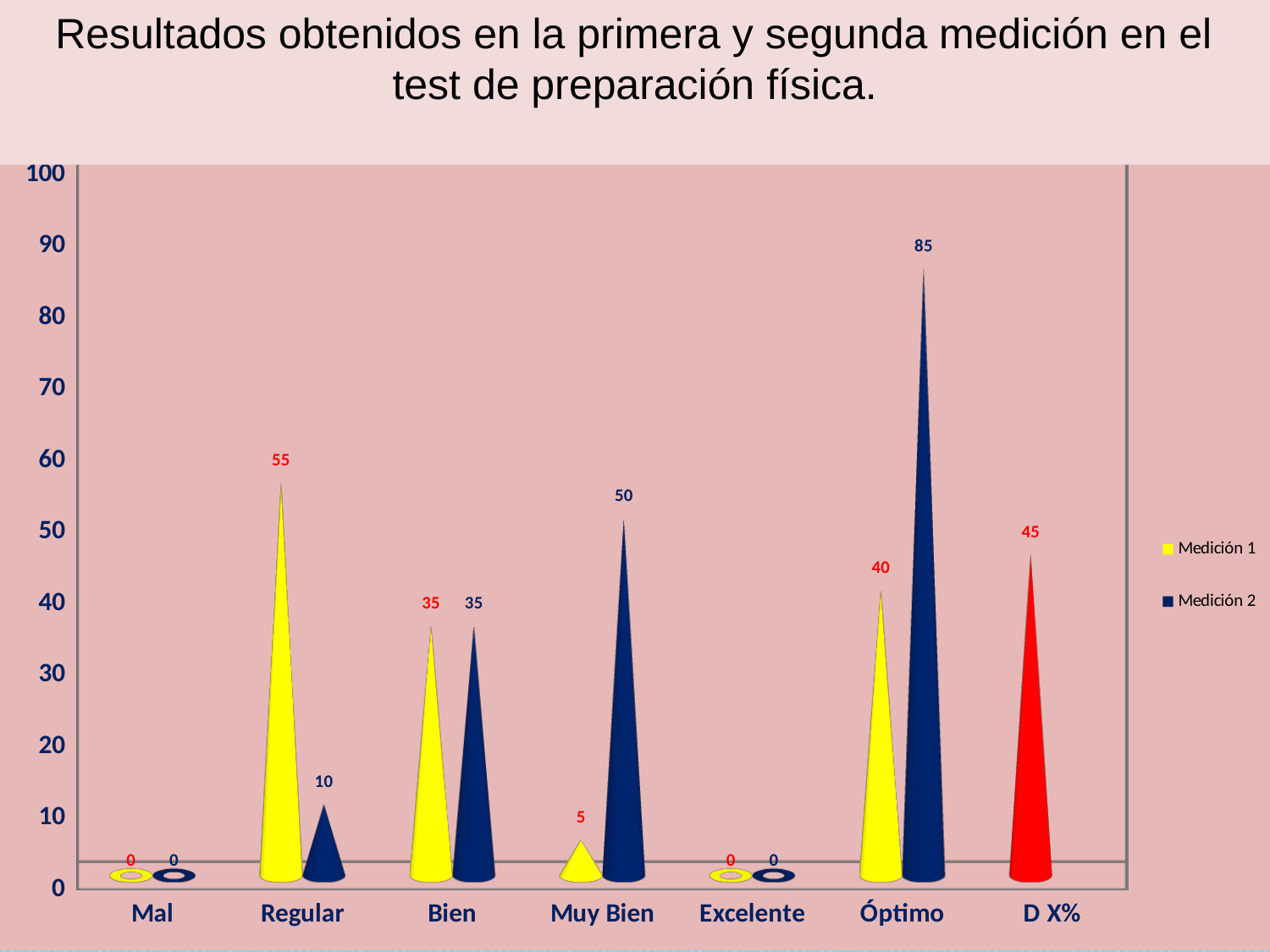
Which category has the highest value for Medición 2? Óptimo Which category has the highest value for Medición 1? Regular How many categories are shown on the x axis? 7 What is the difference between Medición 2 and Medición 1 in the Óptimo category? 45 What colour represents Medición 2 in the legend? Dark blue What value is shown for Medición 1 in the Muy Bien category? 5 What value is shown for Medición 2 in the Muy Bien category? 50 What value is shown for Medición 1 in the Regular category? 55 What value is shown for Medición 2 in the Óptimo category? 85 What is the difference between Medición 1 and Medición 2 in the Regular category? 45 In the Bien category, which is larger, Medición 1 or Medición 2? They are equal (35) How many series does the legend list? 2